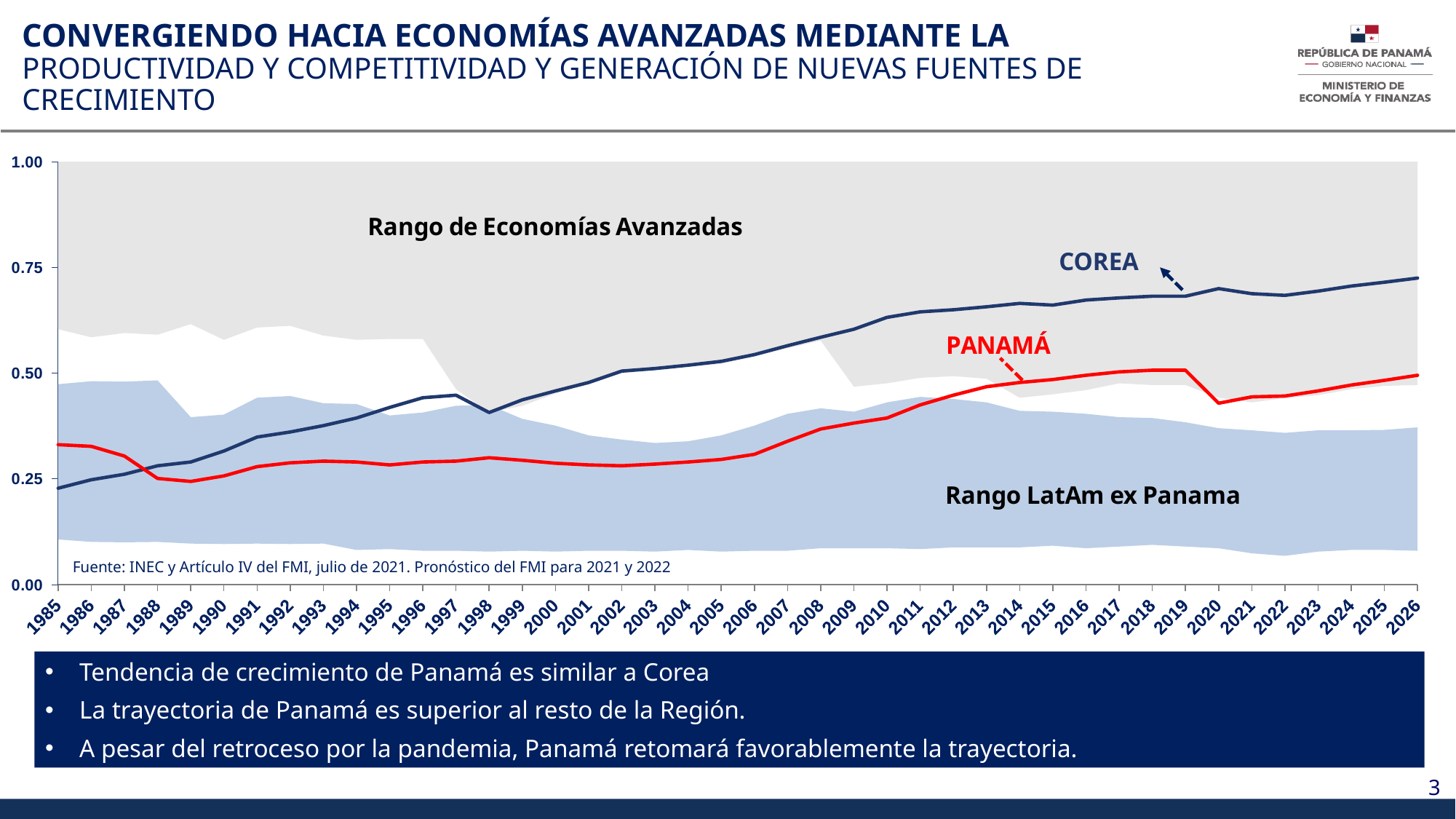
Is the value for PANAMÁ in 1985 greater or less than 0.25? greater Which line has the higher value in 2026, COREA or PANAMÁ? COREA Does the COREA line generally rise or fall from 1985 to 2026? Rise Is the value for COREA in 1985 greater or less than 0.25? less What kind of chart is shown on the slide? Combination area and line chart (lines with shaded range areas) How many years are shown on the x axis of the chart? 42 How many country lines are plotted on the chart? 2 Which line has the higher value in 1985, COREA or PANAMÁ? PANAMÁ Is the value for COREA in 2010 greater or less than 0.50? greater What is the label of the upper shaded area on the chart? Rango de Economías Avanzadas